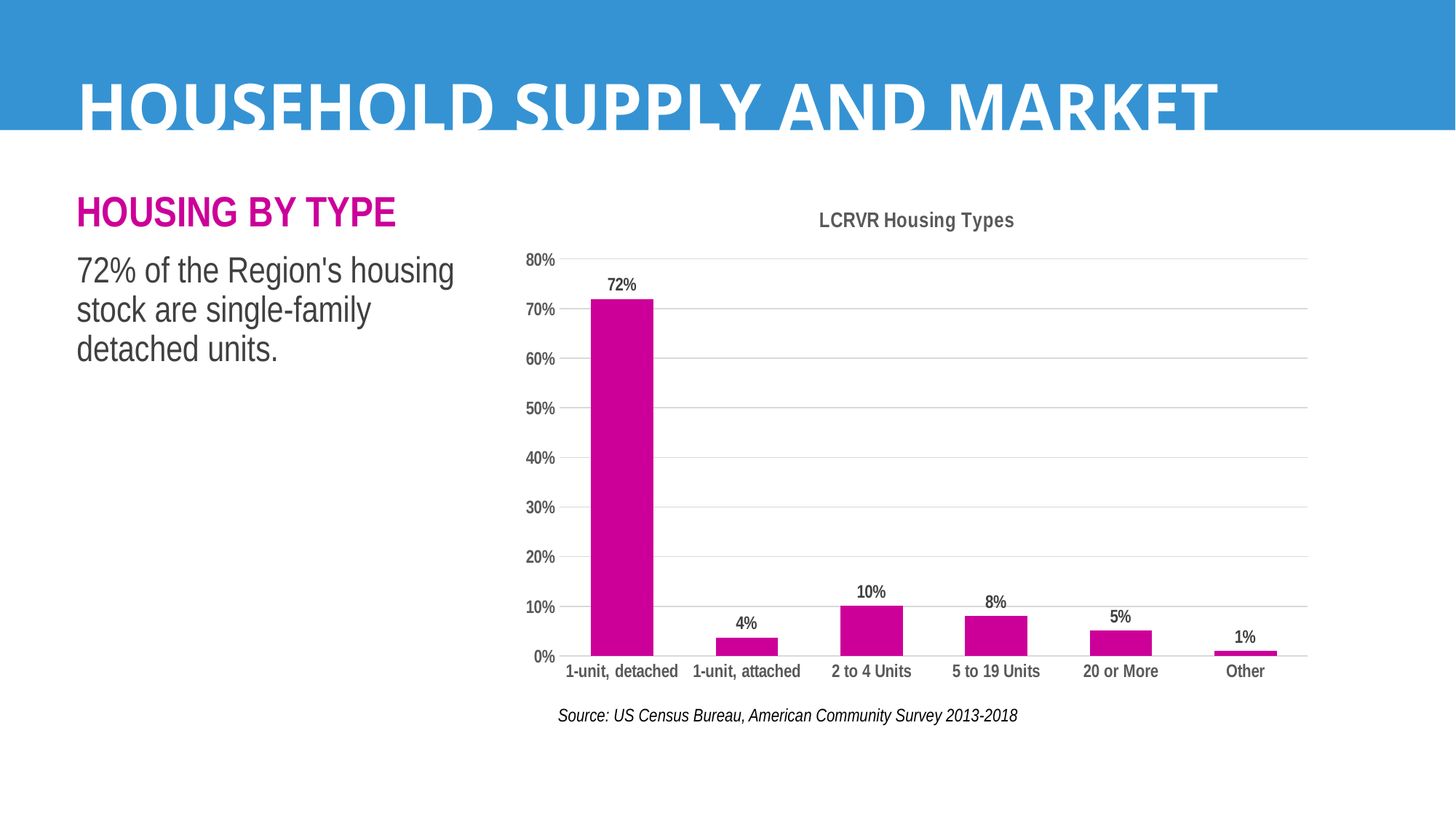
What is the value for 2 to 4 Units? 10% What is the value for 1-unit, detached? 72% Which housing type has the lowest value? Other Which housing type has the highest value? 1-unit, detached What is the difference between the values for 5 to 19 Units and 1-unit, attached? 4% What is the title of the chart? LCRVR Housing Types What is the value for Other? 1% What kind of chart is shown on the slide? Bar chart What is the value for 20 or More? 5% How many housing type categories are shown on the chart? 6 Which is larger, the value for 2 to 4 Units or the value for 5 to 19 Units? 2 to 4 Units What is the difference between the values for 1-unit, detached and 2 to 4 Units? 62%